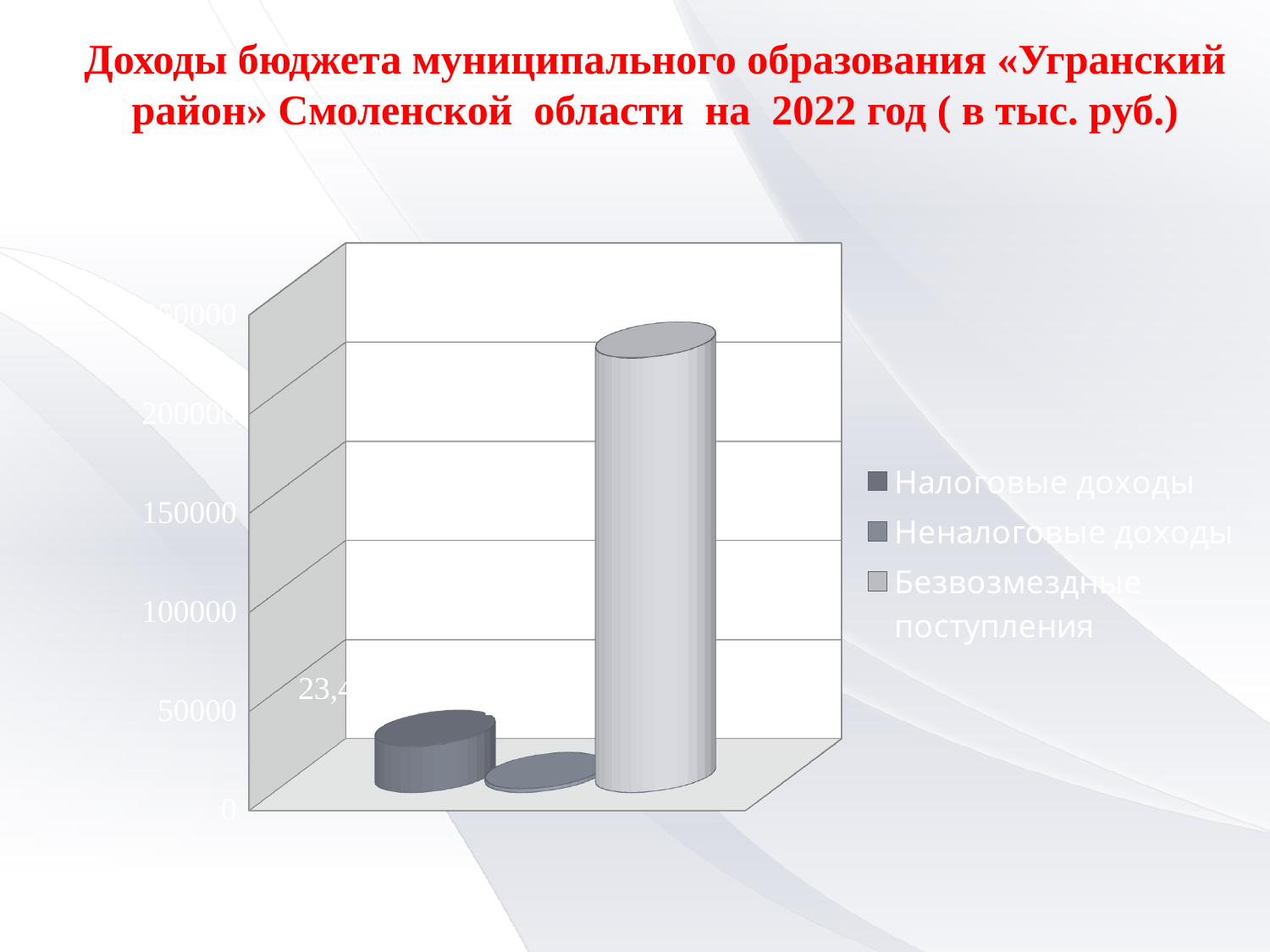
In what units are the values on the chart expressed, according to the slide title? тыс. руб. What kind of chart is shown on the slide? bar chart Is the value for Безвозмездные поступления greater or less than 200000? greater Which is larger: Налоговые доходы or Безвозмездные поступления? Безвозмездные поступления Which series has the lowest value? Неналоговые доходы Which series has the highest value? Безвозмездные поступления How many series does the legend list? 3 How many bars are plotted in the chart? 3 Is the value for Налоговые доходы greater or less than 50000? less Is the value for Неналоговые доходы greater or less than 50000? less Which is larger: Налоговые доходы or Неналоговые доходы? Налоговые доходы For which year does the slide title say the budget revenues are shown? 2022